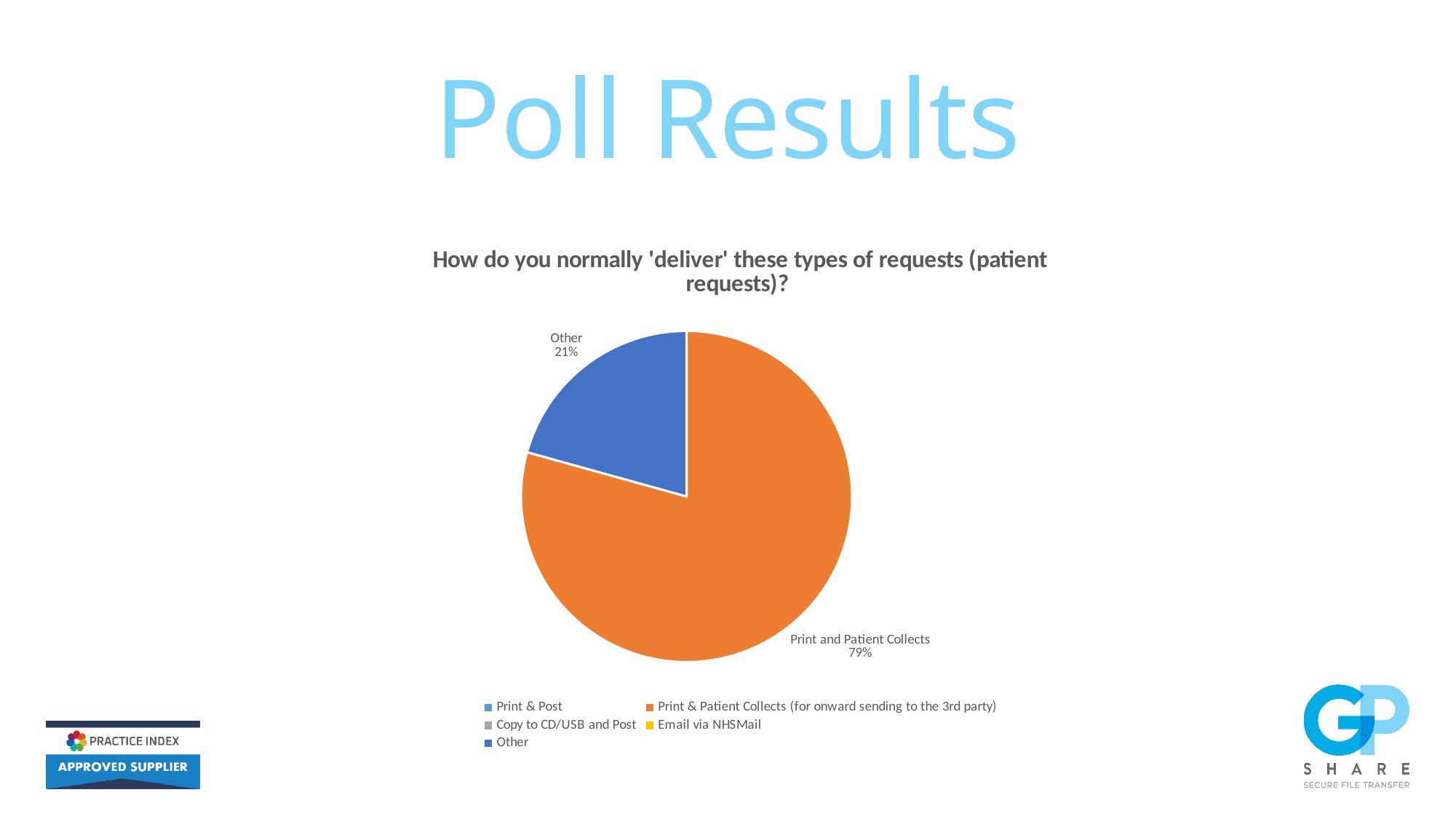
What share of the pie does 'Other' take? 21% How many entries does the legend list? 5 What colour is the 'Other' slice of the pie? blue How many slices are visible in the pie? 2 What kind of chart is shown on the slide? pie chart Which category has the largest slice of the pie? Print and Patient Collects Which is larger, the 'Other' slice or the 'Print and Patient Collects' slice? Print and Patient Collects What is the title of the chart? How do you normally 'deliver' these types of requests (patient requests)? What share of the pie does 'Print and Patient Collects' take? 79% Which of the two labelled slices is smaller, 'Other' or 'Print and Patient Collects'? Other What is the difference in percentage points between the 'Print and Patient Collects' slice and the 'Other' slice? 58